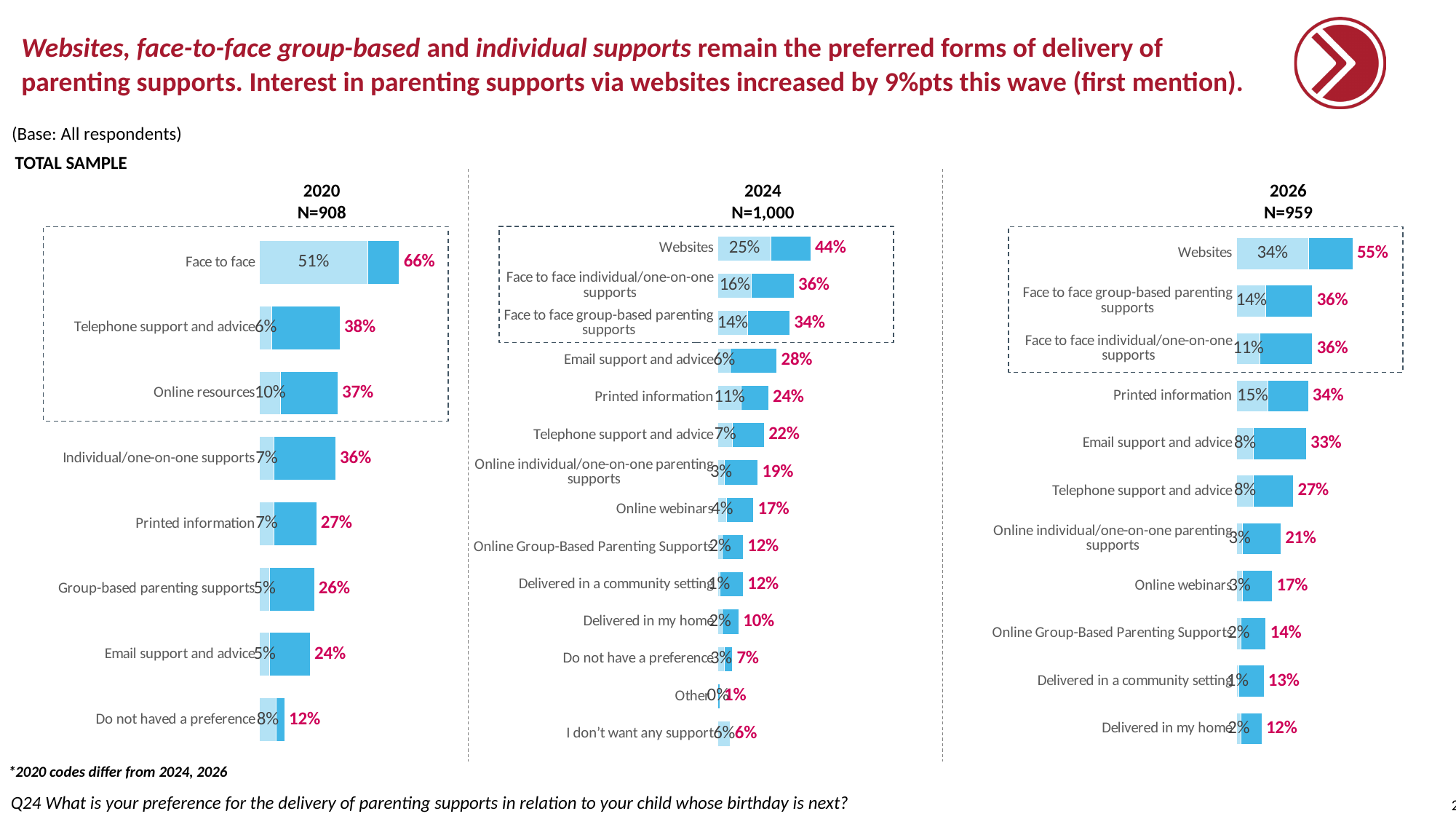
In the 2020 chart, which category has the highest total percentage? Face to face How many categories are shown in the 2024 chart? 14 What type of chart is used for the 2020 data? Bar chart In the 2024 chart, what is the total percentage shown for Websites? 44% In the 2024 chart, which category has the lowest total percentage? Other In the 2020 chart, what is the total percentage shown for Telephone support and advice? 38% What is the sample size (N) shown for the 2024 chart? N=1,000 In the 2026 chart, which has a higher total percentage: Printed information or Telephone support and advice? Printed information In the 2026 chart, which category has the lowest total percentage? Delivered in my home In the 2026 chart, what is the first-mention (light blue) percentage shown for Websites? 34% What is the difference between the total percentage for Websites in the 2026 chart and in the 2024 chart? 11% How many categories are shown in the 2026 chart? 11